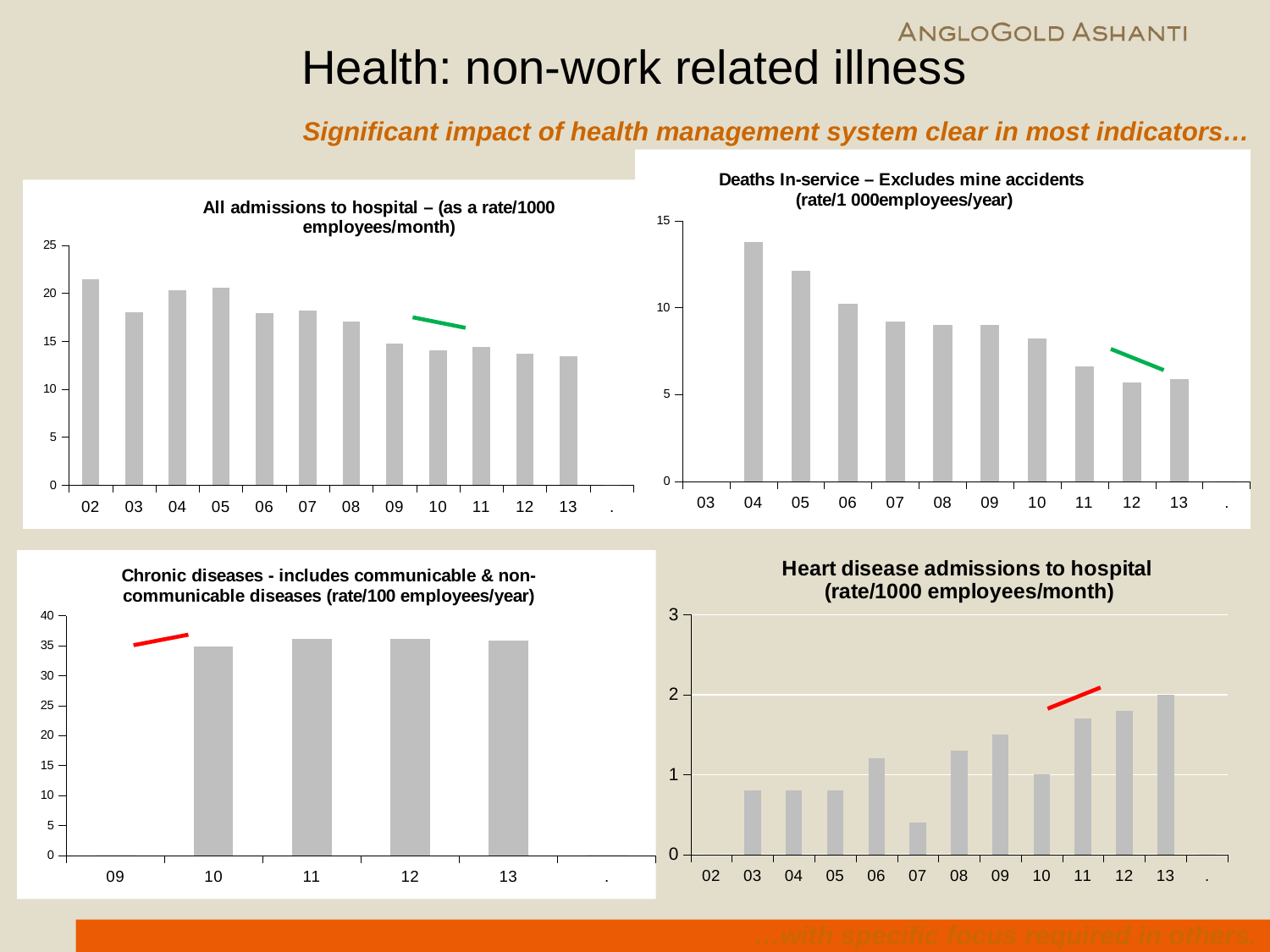
In the 'Heart disease admissions to hospital' chart, do the values generally rise or fall from 03 to 13? rise In the 'Chronic diseases' chart, is the value for 10 greater or less than 30? greater In the 'Deaths In-service' chart, is the value for 04 greater or less than 10? greater In the 'All admissions to hospital' chart, is the value for 02 greater or less than 20? greater In the 'All admissions to hospital' chart, which year has the highest value? 02 What type of chart is the 'Heart disease admissions to hospital' chart? bar chart In the 'All admissions to hospital' chart, do the values generally rise or fall from 02 to 13? fall In the 'Heart disease admissions to hospital' chart, which year has the lowest value? 07 In the 'Deaths In-service' chart, which year has the highest value? 04 In the 'Deaths In-service' chart, which is larger, the value for 05 or the value for 11? 05 In the 'Chronic diseases' chart, how many bars are plotted? 4